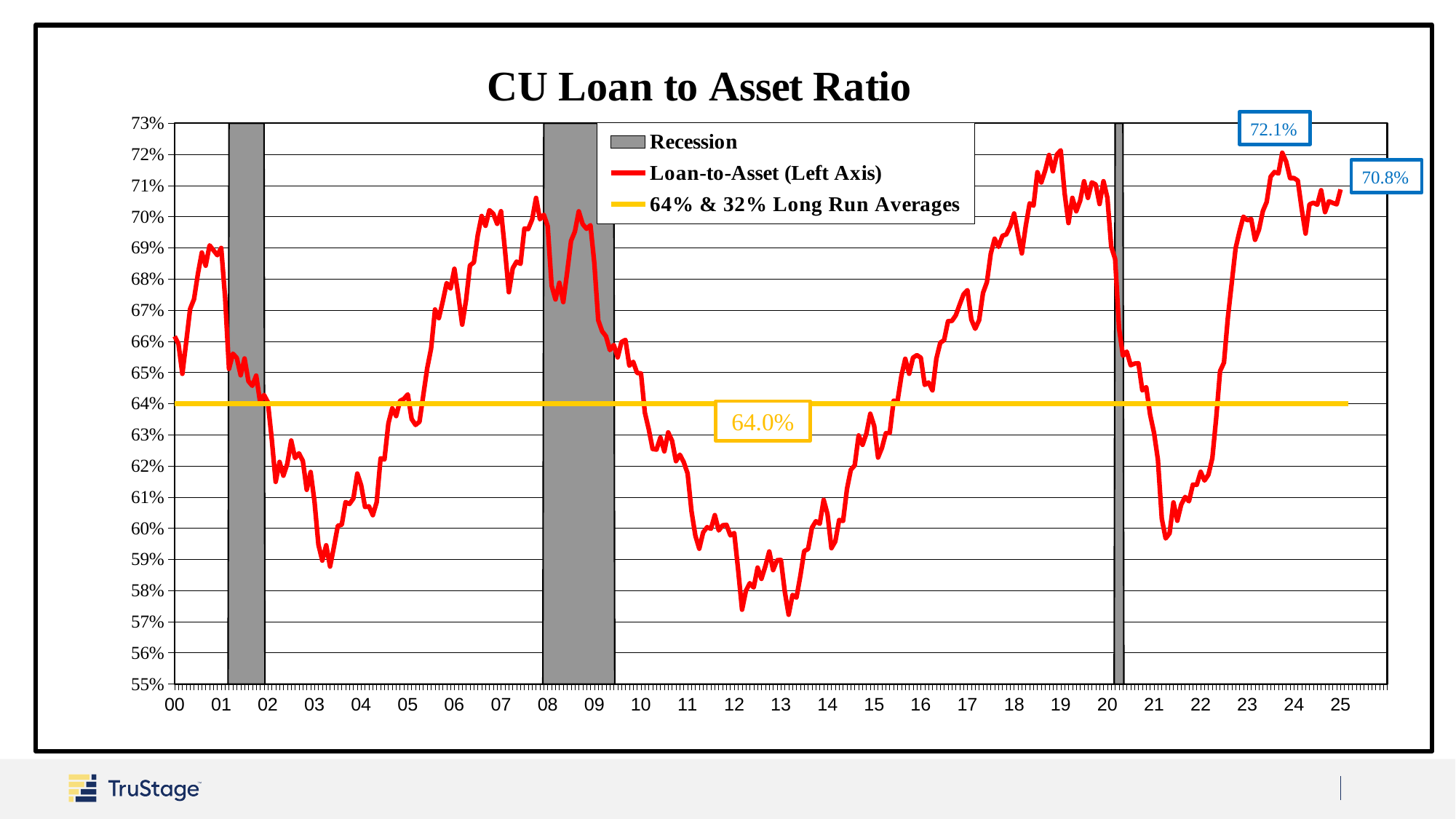
What is the difference between the labeled 2023 peak (72.1%) and the latest labeled value (70.8%)? 1.3 percentage points Is the loan-to-asset ratio at its low point around 2013 greater or less than 60%? less What is the title of the chart? CU Loan to Asset Ratio Does the loan-to-asset ratio rise or fall between 2021 and 2023? rise What is the most recent labeled value of the loan-to-asset ratio, at the right end of the line? 70.8% By how much does the latest labeled value (70.8%) exceed the 64.0% long run average? 6.8 percentage points What kind of chart is shown on the slide? line chart Which is larger, the labeled 2023 peak or the latest labeled value? the 2023 peak (72.1%) What do the grey shaded vertical bands on the chart represent? Recession What is the labeled peak value of the loan-to-asset ratio around 2023? 72.1% What value is labeled on the long run average line? 64.0% How many entries does the chart's legend list? 3